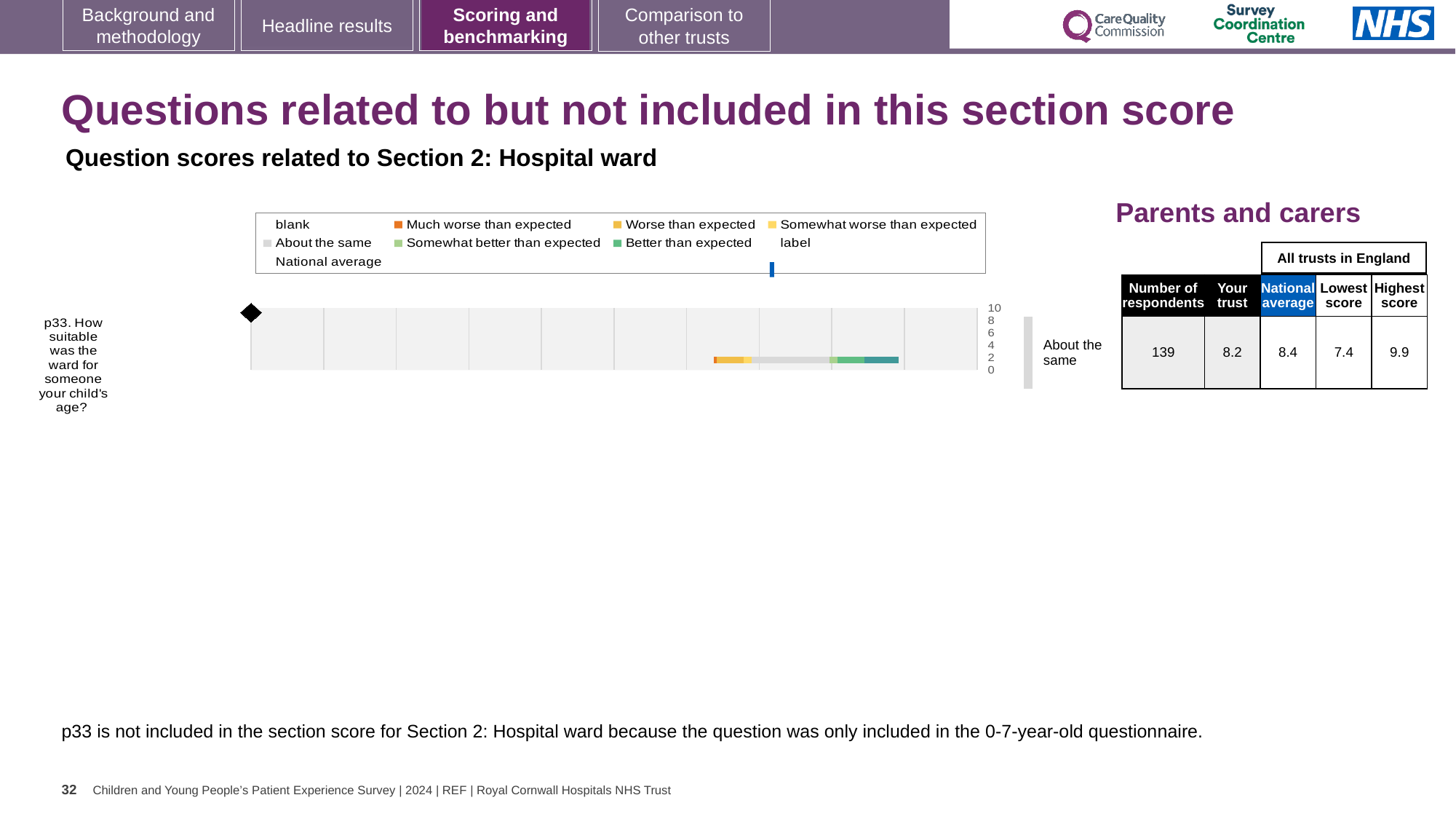
In the table beside the chart, what is the national average score for p33? 8.4 For p33, what is the difference between the highest score and the lowest score among all trusts in England? 2.5 In the table beside the chart, what is the 'Your trust' score for p33? 8.2 In the table beside the chart, what is the lowest score among all trusts in England for p33? 7.4 What benchmark category label is shown to the right of the p33 bar? About the same In the table beside the chart, how many respondents answered p33? 139 What is the highest tick value shown on the chart's score axis? 10 For p33, which is larger: the 'Your trust' score or the national average? National average In the table beside the chart, what is the highest score among all trusts in England for p33? 9.9 What kind of chart is used to show the p33 benchmarking result? bar chart How many questions are plotted in the chart? 1 Which question is plotted in the chart? p33. How suitable was the ward for someone your child's age?